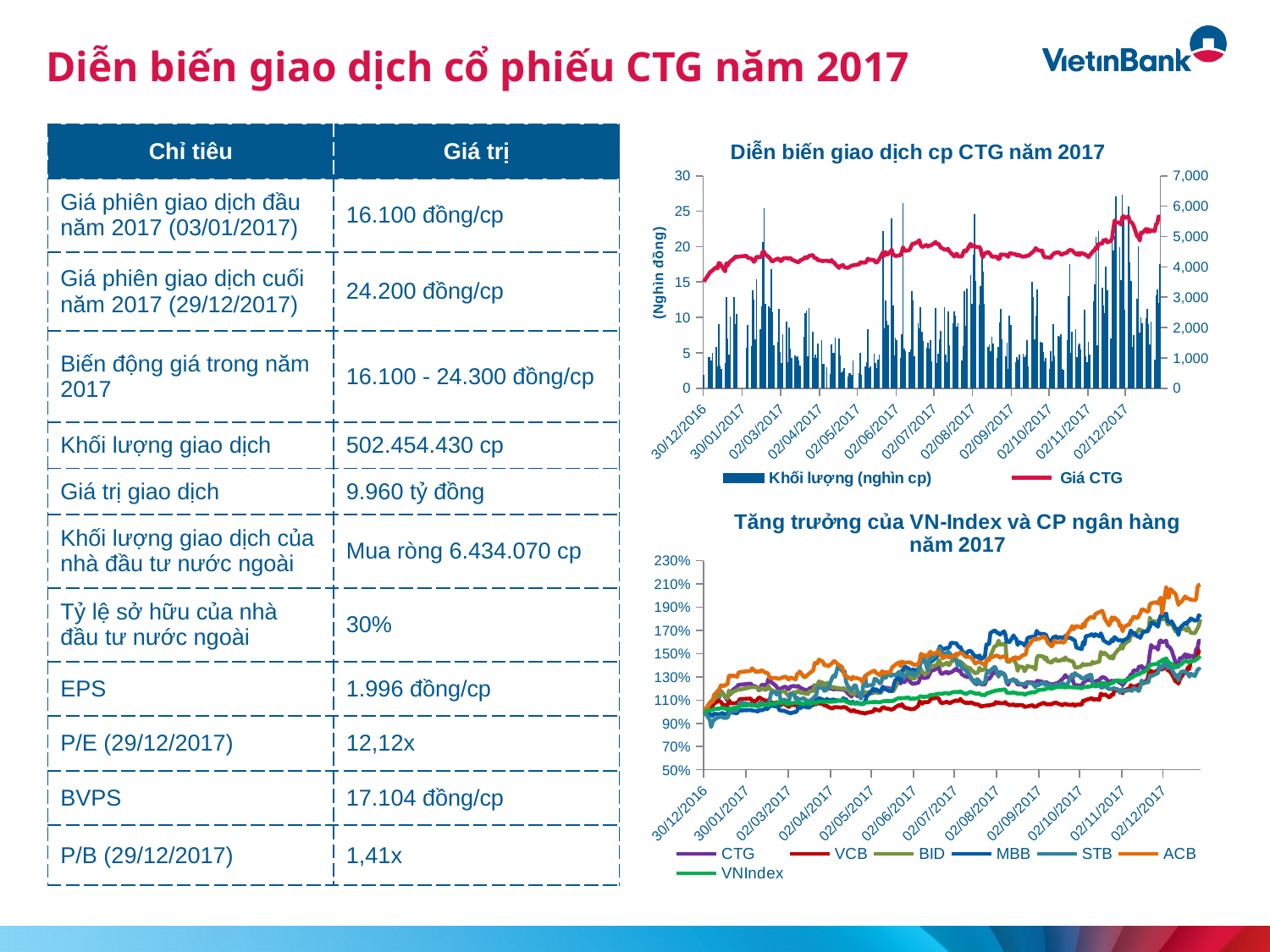
What kind of chart is the bottom chart titled 'Tăng trưởng của VN-Index và CP ngân hàng năm 2017'? Line chart How many series does the legend of the top chart 'Diễn biến giao dịch cp CTG năm 2017' list? 2 In the top chart 'Diễn biến giao dịch cp CTG năm 2017', which series is drawn as bars? Khối lượng (nghìn cp) In the top chart 'Diễn biến giao dịch cp CTG năm 2017', is the Giá CTG value at the start of the period (30/12/2016) greater or less than 20 on the left axis? less In the bottom chart 'Tăng trưởng của VN-Index và CP ngân hàng năm 2017', which series is highest at the end of the period (December 2017)? ACB In the bottom chart 'Tăng trưởng của VN-Index và CP ngân hàng năm 2017', is the ACB value at the end of the period greater or less than 190%? greater In the top chart 'Diễn biến giao dịch cp CTG năm 2017', which series is drawn as a line? Giá CTG How many series does the legend of the bottom chart 'Tăng trưởng của VN-Index và CP ngân hàng năm 2017' list? 7 In the bottom chart 'Tăng trưởng của VN-Index và CP ngân hàng năm 2017', do the series overall rise or fall across 2017? Rise What kind of chart is the top chart titled 'Diễn biến giao dịch cp CTG năm 2017'? A combination bar and line chart In the top chart 'Diễn biến giao dịch cp CTG năm 2017', is the Giá CTG value at the end of the period (December 2017) greater or less than 20 on the left axis? greater In the top chart 'Diễn biến giao dịch cp CTG năm 2017', does the Giá CTG line overall rise or fall from the start to the end of 2017? Rise